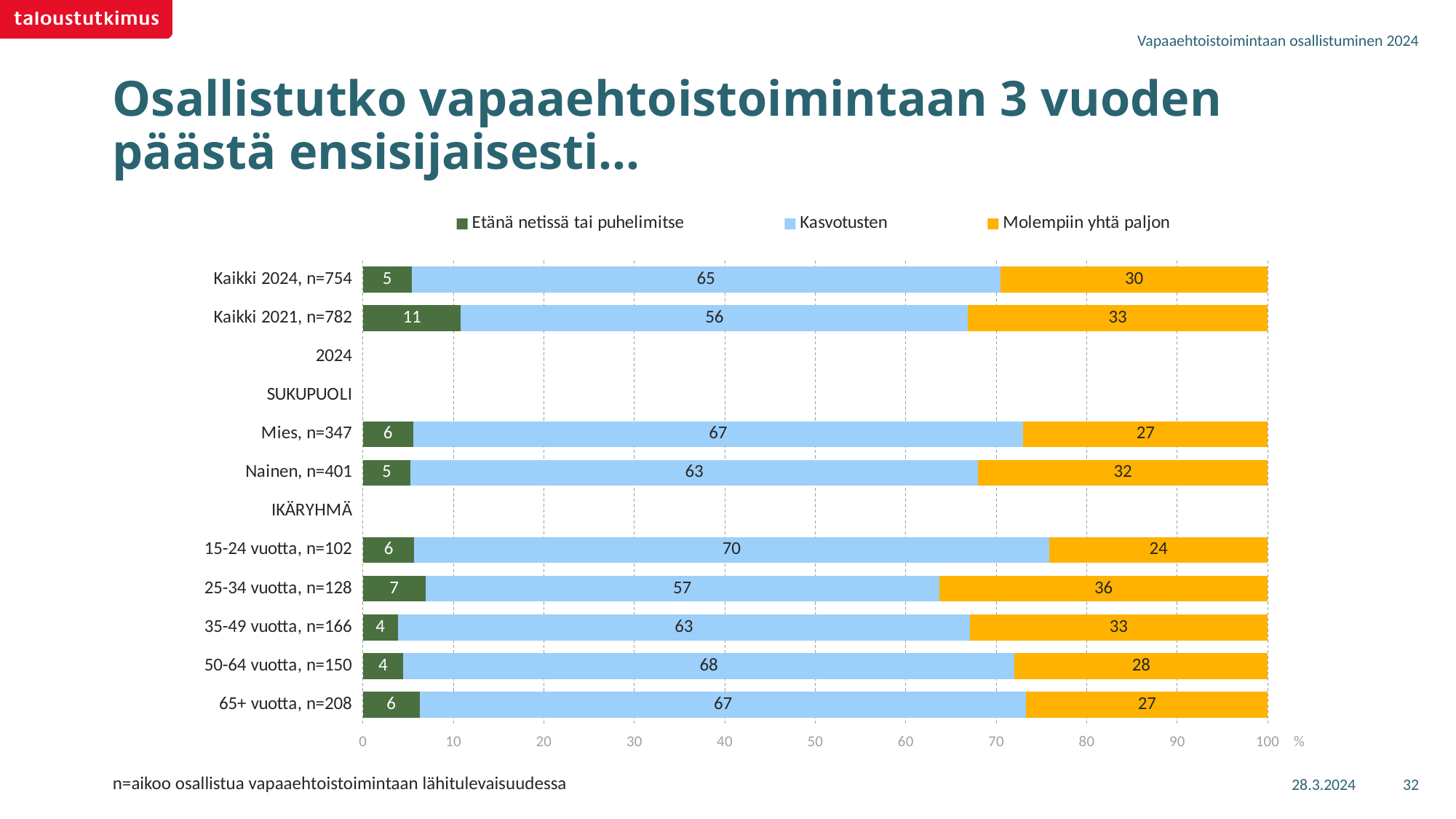
What is the difference between the Kasvotusten values for Kaikki 2024, n=754 and Kaikki 2021, n=782? 9 Which colour represents Kasvotusten in the chart? Light blue Which has a larger Molempiin yhtä paljon value, Mies, n=347 or Nainen, n=401? Nainen, n=401 How many bars with data are plotted in the chart? 9 Which category has the highest Kasvotusten value? 15-24 vuotta, n=102 Which category has the lowest Molempiin yhtä paljon value? 15-24 vuotta, n=102 How many series does the legend list? 3 What kind of chart is shown on the slide? Stacked bar chart What is the Kasvotusten value for Kaikki 2024, n=754? 65 What is the total of the stacked bar for 50-64 vuotta, n=150? 100 What is the Etänä netissä tai puhelimitse value for Kaikki 2021, n=782? 11 What is the Molempiin yhtä paljon value for 25-34 vuotta, n=128? 36